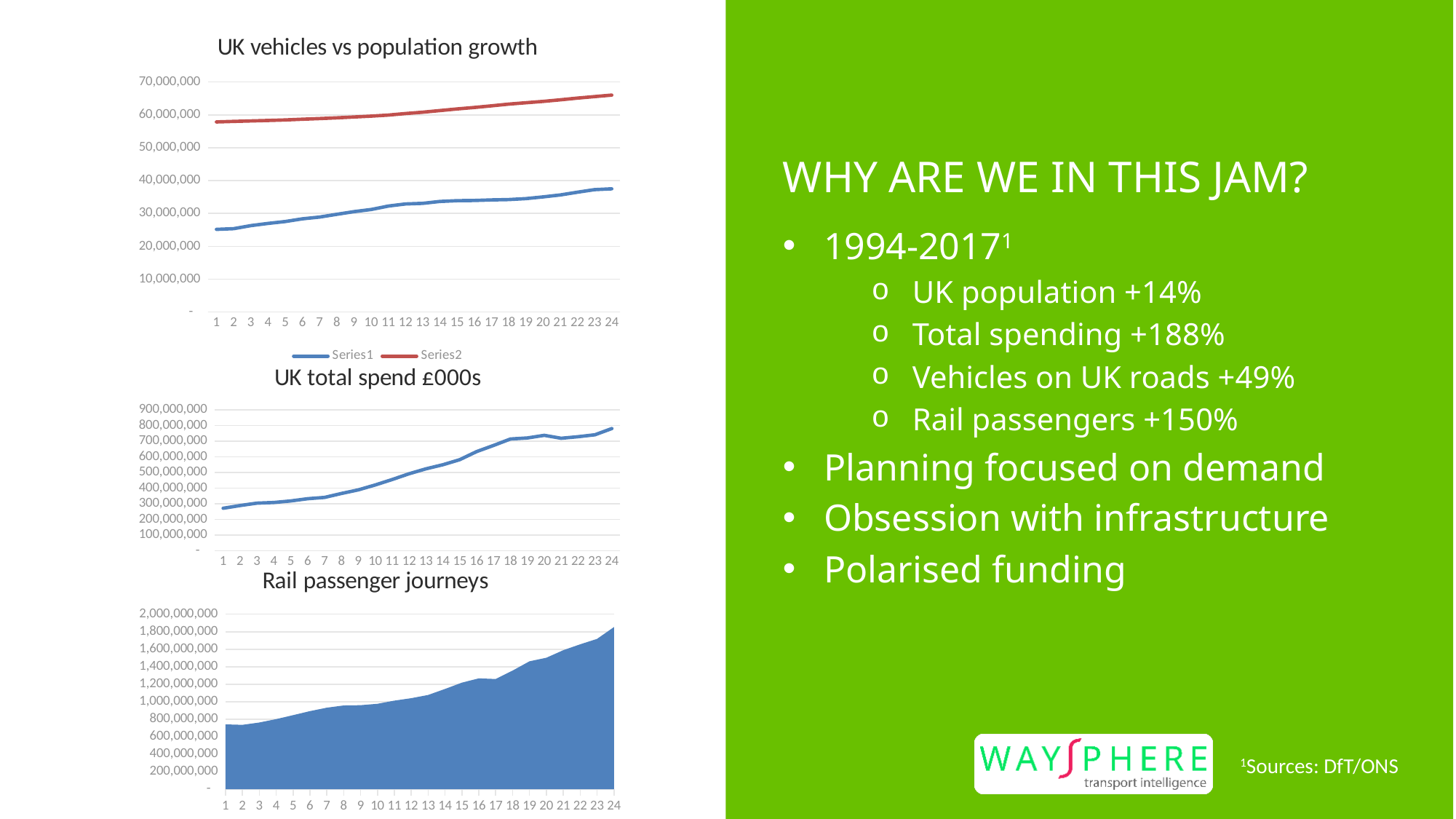
In the 'UK vehicles vs population growth' chart, is the value of Series2 at point 1 greater or less than 50,000,000? greater In the 'UK total spend £000s' chart, do the values generally rise or fall from point 1 to point 24? rise In the 'UK vehicles vs population growth' chart, which series has the higher value at point 24, Series1 or Series2? Series2 In the 'UK total spend £000s' chart, is the value at point 1 greater or less than 300,000,000? less In the 'Rail passenger journeys' chart, which point has the highest value? 24 In the 'Rail passenger journeys' chart, is the value at point 1 greater or less than 800,000,000? less In the 'UK total spend £000s' chart, how many points are plotted along the x axis? 24 What kind of chart is 'UK total spend £000s'? line chart In the 'UK vehicles vs population growth' chart, how many series does the legend list? 2